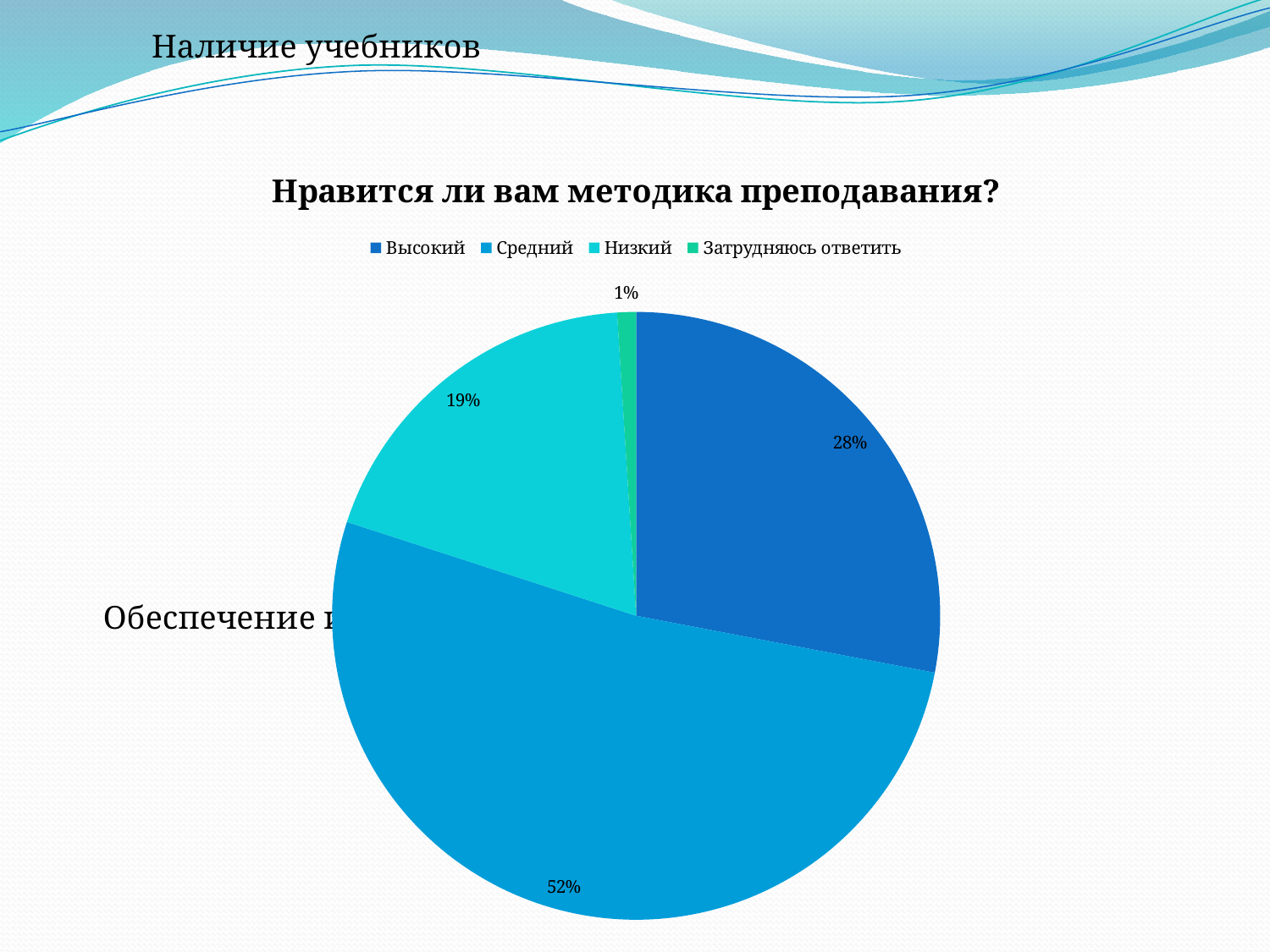
What share of the pie is labelled Высокий? 28% Which category has the largest slice? Средний What is the title of the chart? Нравится ли вам методика преподавания? How many slices does the pie chart have? 4 What share of the pie is labelled Затрудняюсь ответить? 1% Which slice is larger, Высокий or Низкий? Высокий What share of the pie is labelled Низкий? 19% What kind of chart is shown on the slide? pie chart How many categories does the legend list? 4 Which category has the smallest slice? Затрудняюсь ответить What is the difference in percentage points between the Средний and Высокий slices? 24 What share of the pie is labelled Средний? 52%